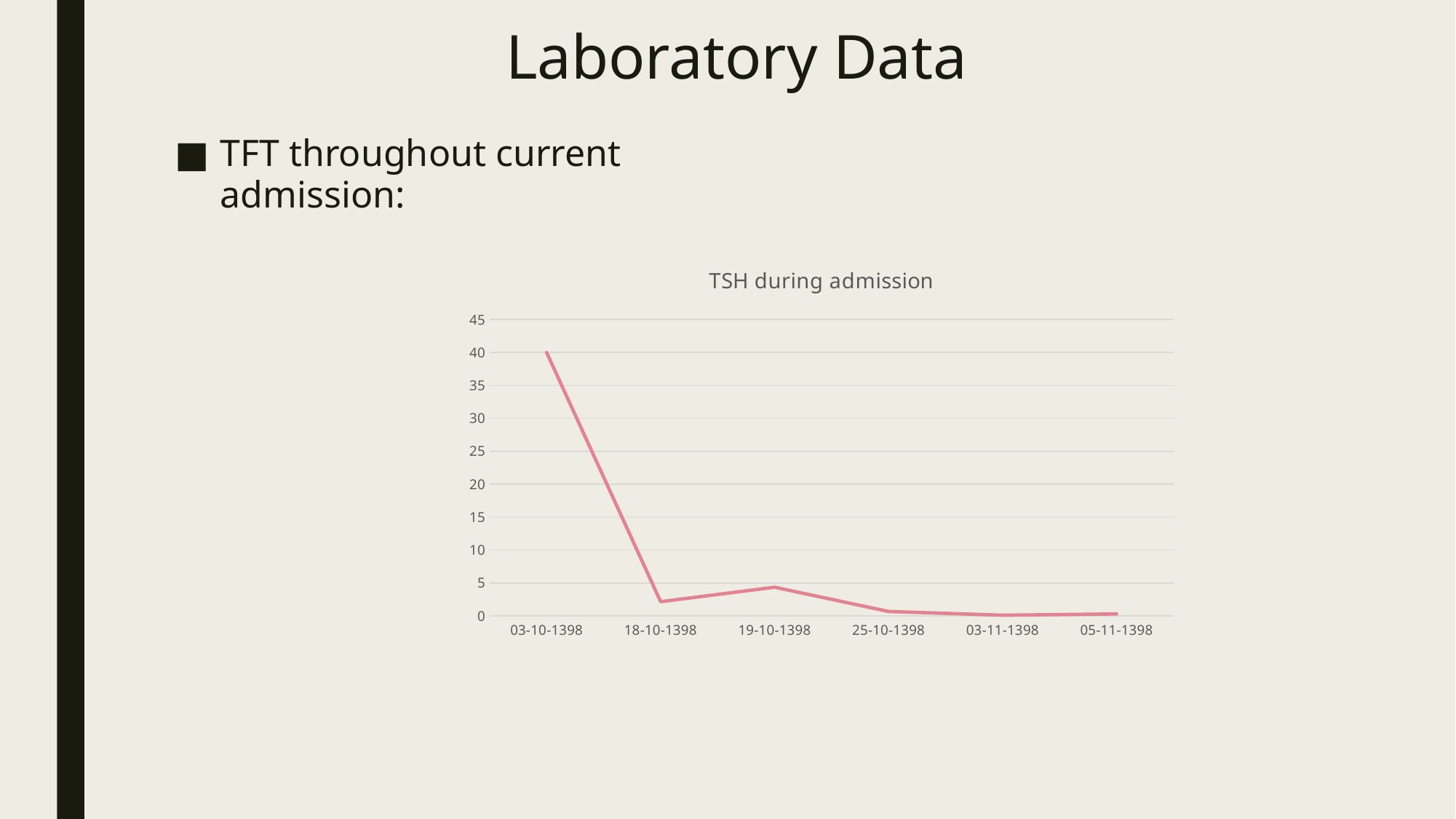
Which date has the larger TSH value, 03-10-1398 or 18-10-1398? 03-10-1398 What kind of chart is shown on the slide? line chart What is the TSH value on 03-10-1398? 40 Is the TSH value on 19-10-1398 greater or less than 10? less On which date is the TSH value highest? 03-10-1398 Which date has the larger TSH value, 18-10-1398 or 19-10-1398? 19-10-1398 Is the TSH value on 18-10-1398 greater or less than 5? less How many dates are plotted along the x axis of the chart? 6 What is the title of the chart? TSH during admission Is the TSH value on 25-10-1398 greater or less than 5? less Overall, does the TSH value rise or fall from the first date to the last date? fall